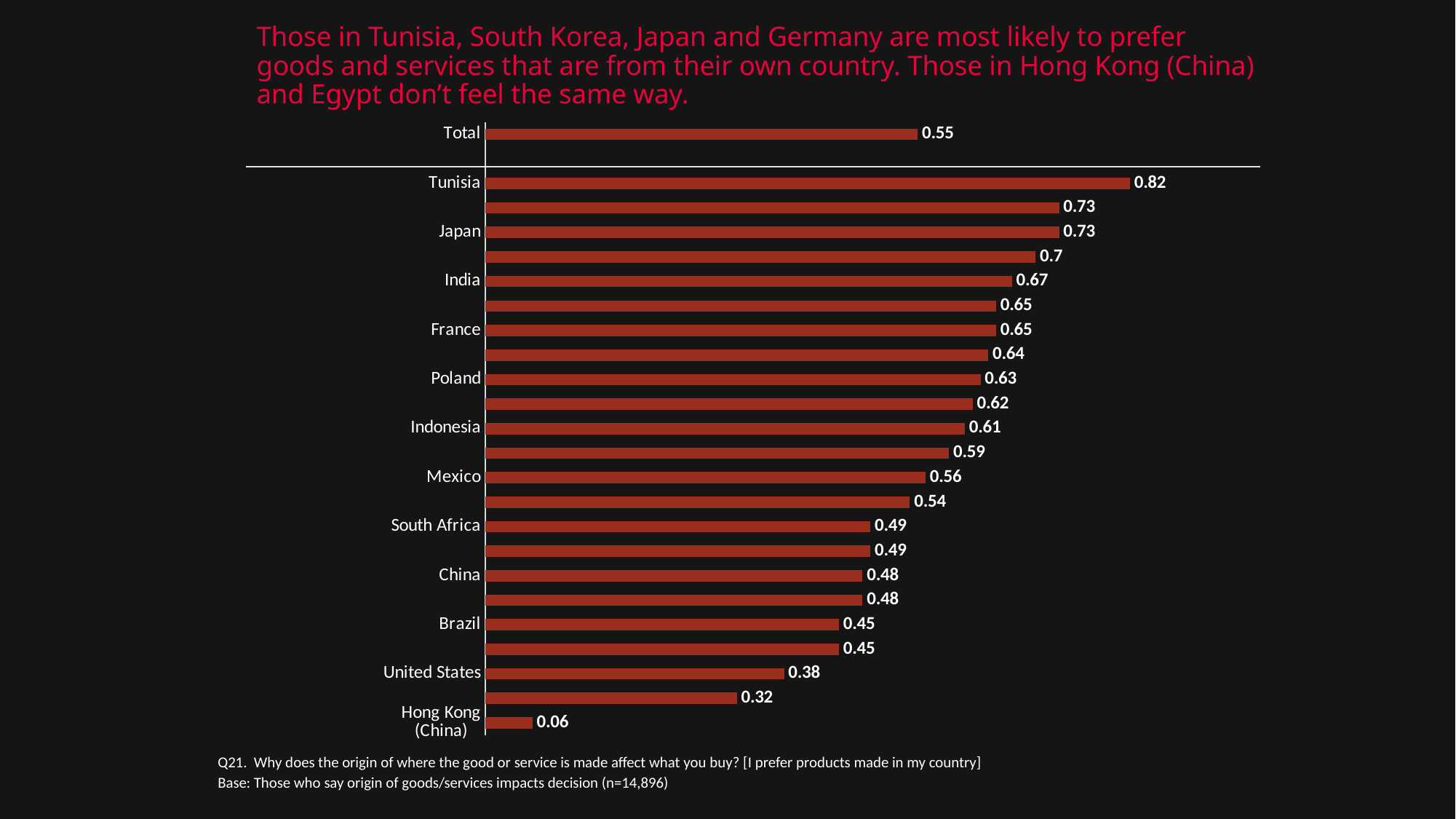
Do the country values rise or fall going down the chart from Tunisia to Hong Kong (China)? Fall What kind of chart is shown on the slide? Bar chart Which has the larger value, France or Poland? France What is the value for Hong Kong (China)? 0.06 What is the value for Tunisia? 0.82 What is the difference between the values for Japan and India? 0.06 What is the value for United States? 0.38 Which labelled country has the highest value? Tunisia Which labelled country has the lowest value? Hong Kong (China) What is the difference between the values for Tunisia and Hong Kong (China)? 0.76 What is the value for Total? 0.55 What is the value for Japan? 0.73